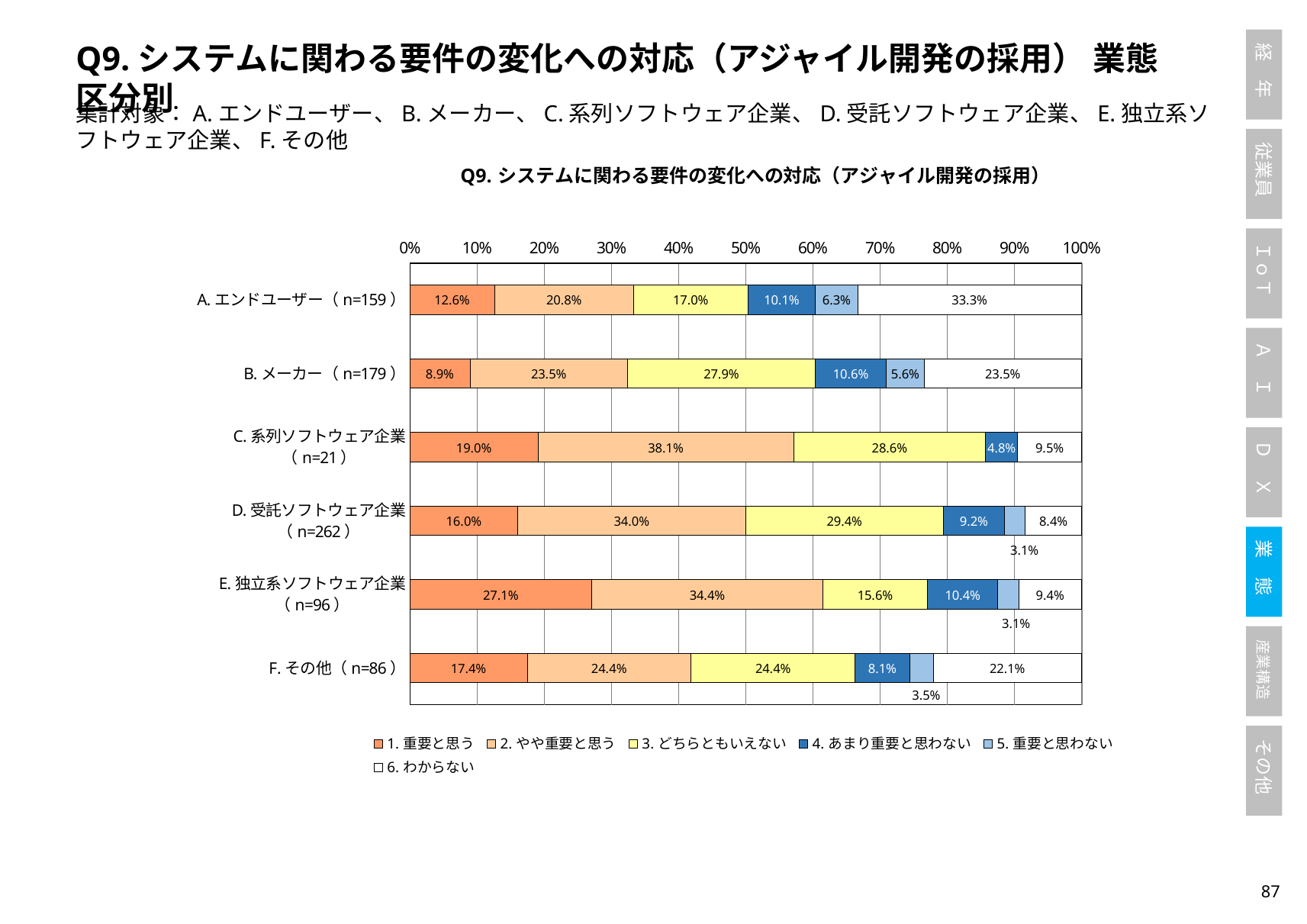
What is the sample size (n) shown for D. 受託ソフトウェア企業? 262 Which is larger: the "4. あまり重要と思わない" value for B. メーカー or for E. 独立系ソフトウェア企業? B. メーカー What is the value of "6. わからない" for D. 受託ソフトウェア企業 (n=262)? 8.4% What is the value of "2. やや重要と思う" for C. 系列ソフトウェア企業 (n=21)? 38.1% How many categories (business types) are shown on the chart? 6 What is the value of "3. どちらともいえない" for B. メーカー (n=179)? 27.9% Which category has the lowest value for "1. 重要と思う"? B. メーカー (n=179) What is the difference between the "6. わからない" values for A. エンドユーザー and F. その他? 11.2% How many series does the legend list? 6 What kind of chart is shown on the slide? Stacked bar chart What is the value of "1. 重要と思う" for A. エンドユーザー (n=159)? 12.6% Which category has the highest value for "1. 重要と思う"? E. 独立系ソフトウェア企業 (n=96)